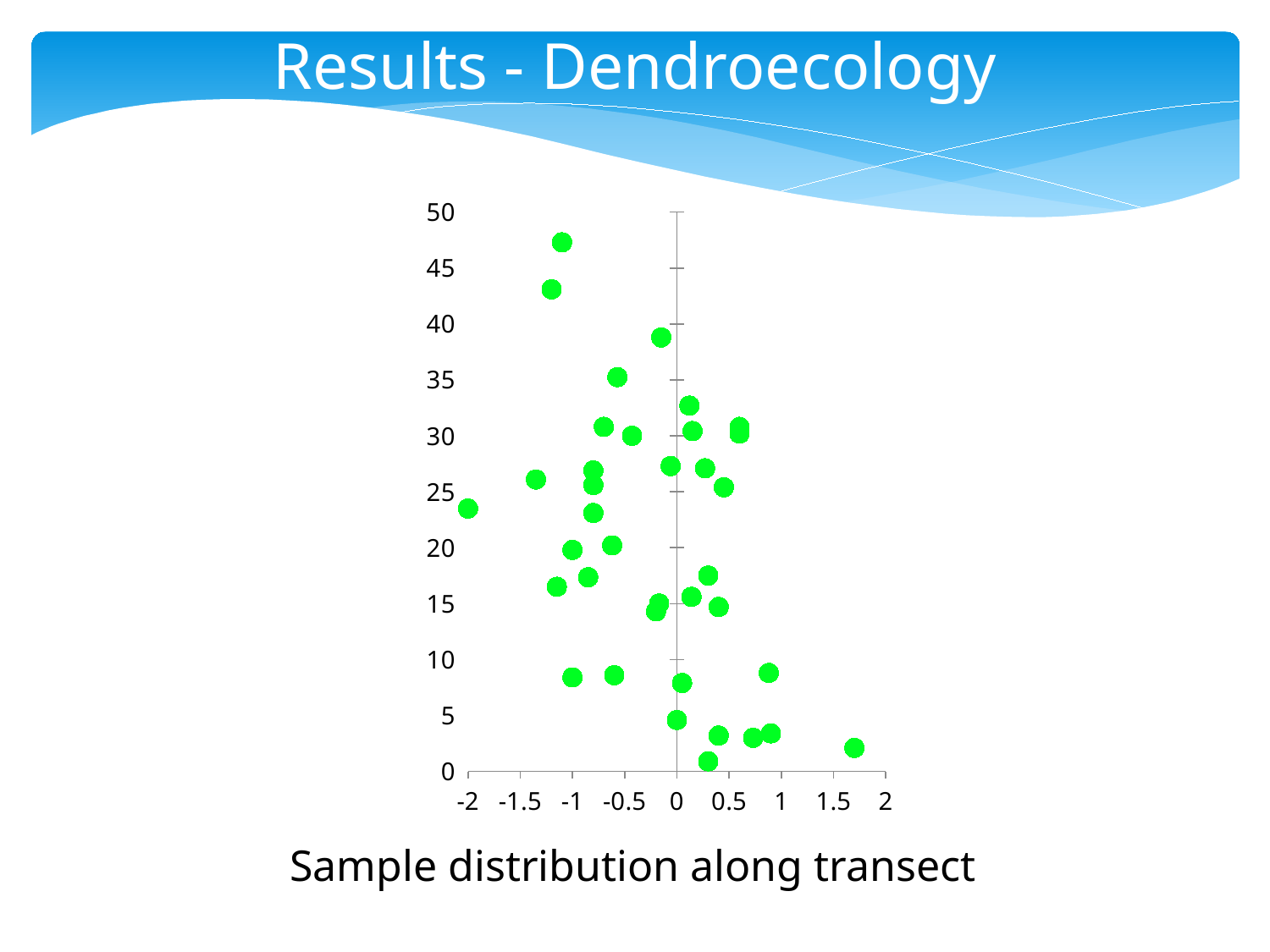
Is the y-value of the lowest point in the chart greater or less than 5? less Is the x-value of the rightmost point in the chart greater or less than 1.5? greater Is the x-value of the leftmost point in the chart greater or less than -1.5? less What caption appears below the chart? Sample distribution along transect What kind of chart is shown on the slide? scatter chart What colour are the data points in the chart? green